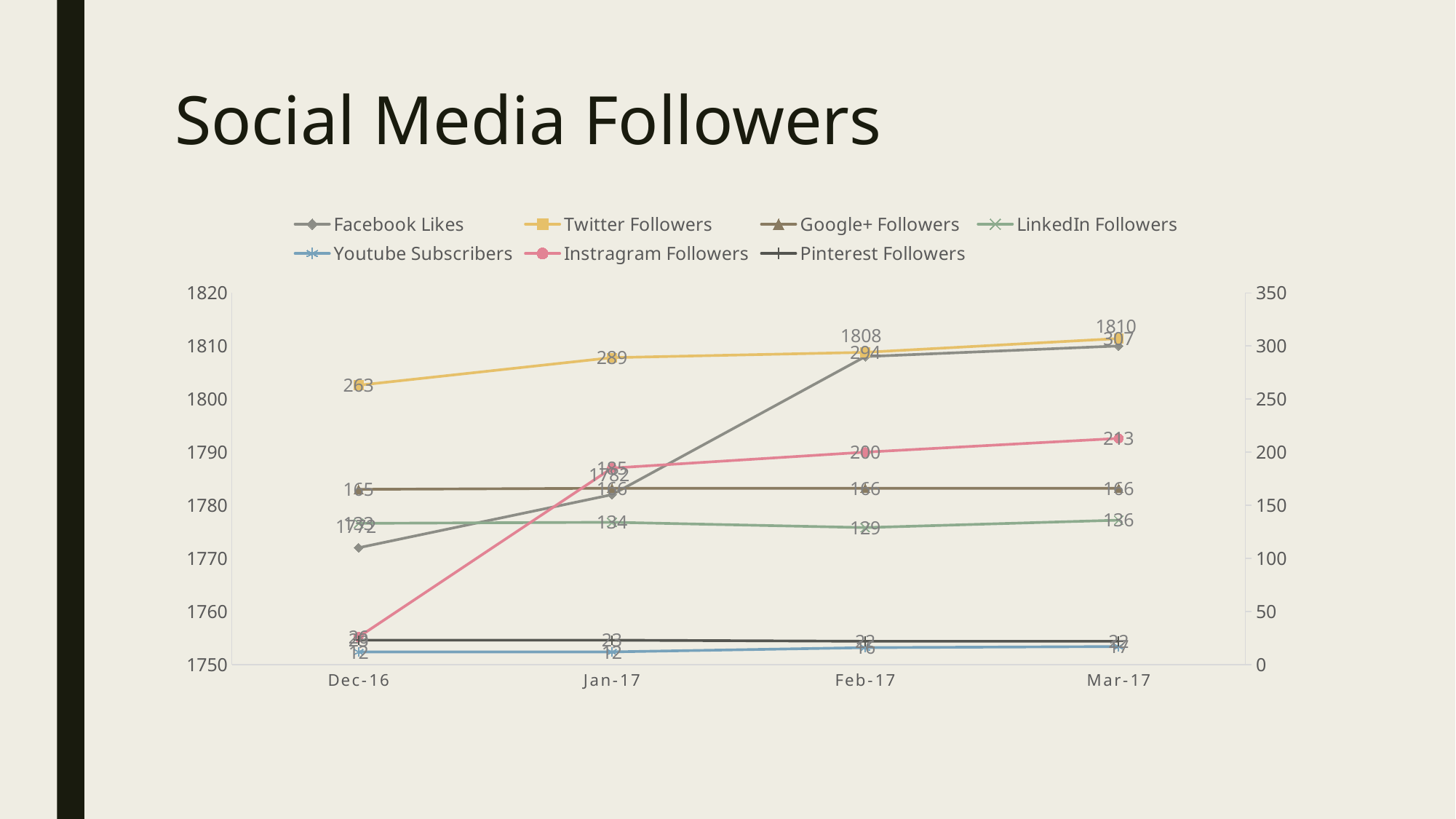
What is the value of Instragram Followers in Mar-17? 213 What is the value of Twitter Followers in Dec-16? 263 How many months are shown on the x axis? 4 By how much did Twitter Followers increase from Dec-16 to Mar-17? 44 Is the value for Instragram Followers in Dec-16 greater or less than 50? less How many series does the legend list? 7 Do Twitter Followers rise or fall from Dec-16 to Mar-17? rise What is the value of Facebook Likes in Feb-17? 1808 In which month are Twitter Followers highest? Mar-17 What is the value of Twitter Followers in Mar-17? 307 What kind of chart is shown on the slide? line chart Which is larger in Feb-17, Twitter Followers or Instragram Followers? Twitter Followers